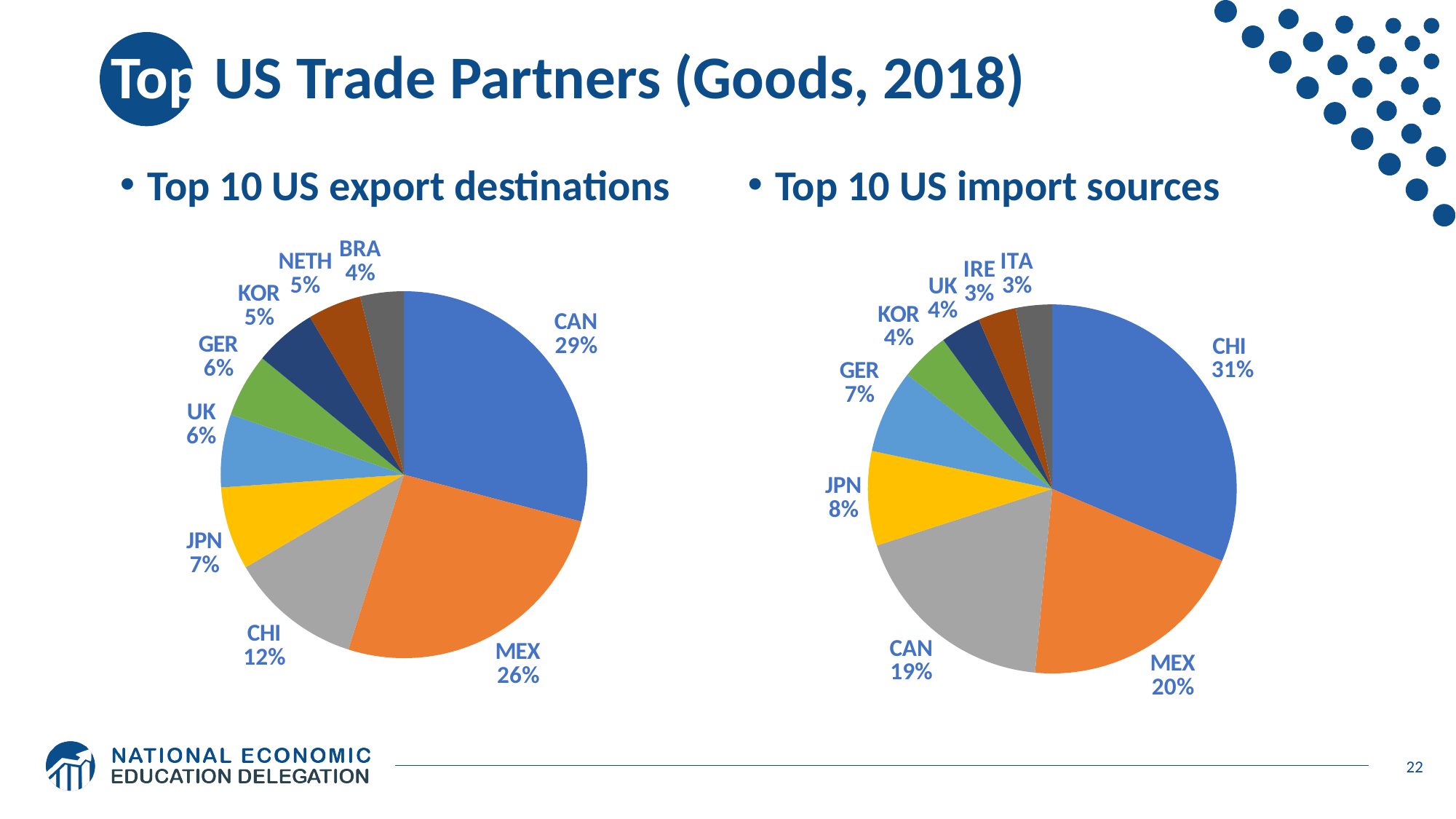
In the Top 10 US export destinations pie chart, which country has the smallest share? BRA In the Top 10 US import sources pie chart, what share does GER have? 7% In the Top 10 US import sources pie chart, which country has the largest share? CHI In the Top 10 US import sources pie chart, which is larger, the share of MEX or the share of JPN? MEX In the Top 10 US export destinations pie chart, which is larger, the share of CHI or the share of JPN? CHI In the Top 10 US export destinations pie chart, which country has the largest share? CAN How many slices does the Top 10 US import sources pie chart have? 9 In the Top 10 US import sources pie chart, what is the difference between the shares of CHI and CAN? 12% In the Top 10 US export destinations pie chart, what share does CAN have? 29% In the Top 10 US export destinations pie chart, what is the difference between the shares of CAN and MEX? 3% In the Top 10 US import sources pie chart, what share does CHI have? 31% What type of chart is used for the Top 10 US export destinations? Pie chart